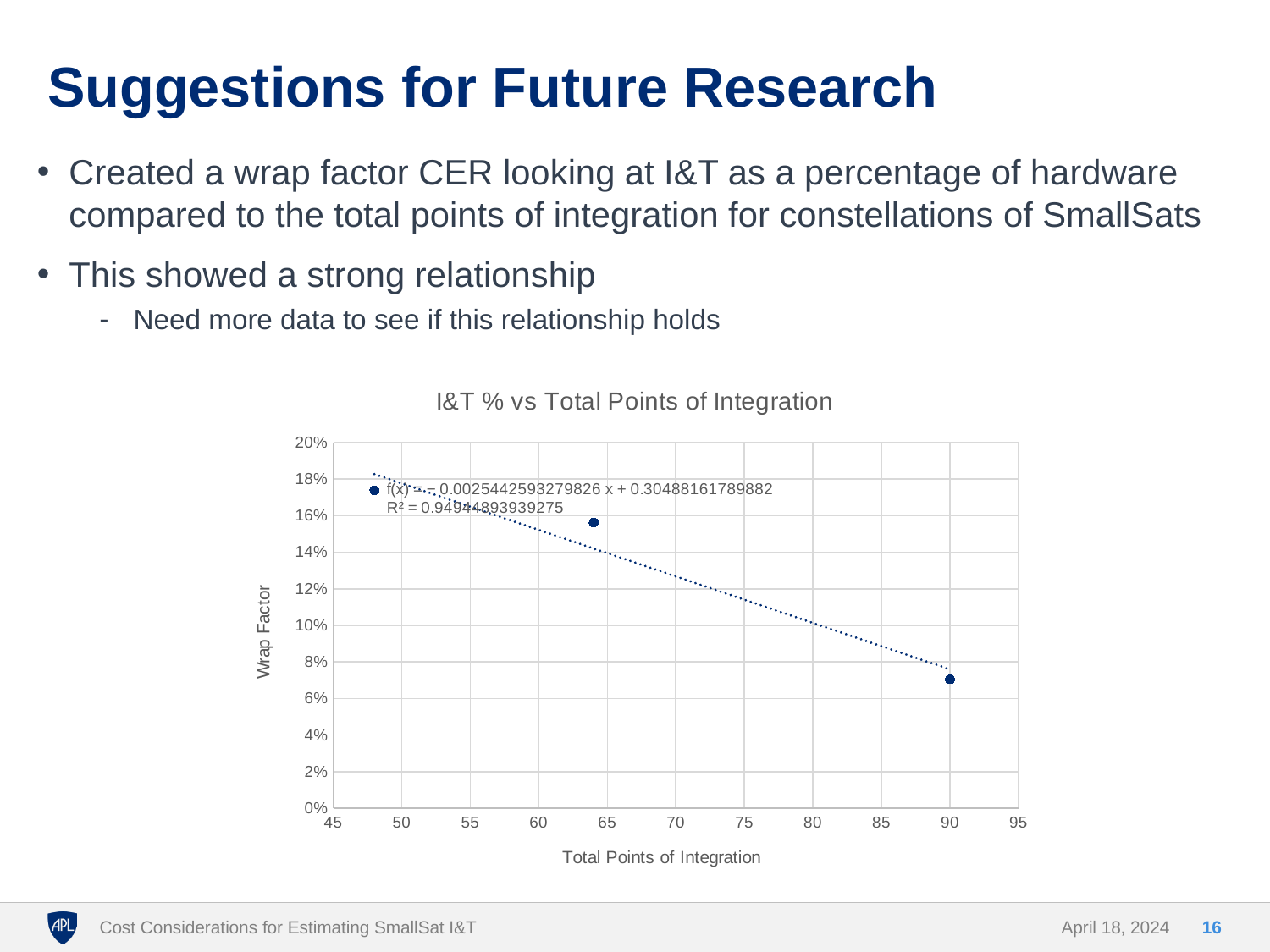
Does the wrap factor rise or fall as total points of integration increases? fall Is the wrap factor for the point at 90 total points of integration greater or less than 8%? less Which has the larger wrap factor, the leftmost point or the middle point? leftmost point What kind of chart is shown on the slide? scatter chart Is the wrap factor for the rightmost point greater or less than 10%? less Is the wrap factor for the middle point greater or less than 14%? greater What is the label of the y axis? Wrap Factor What R² value is printed on the chart for the trendline? 0.949448939393275 What is the title of the chart? I&T % vs Total Points of Integration Which point has the lowest wrap factor, the leftmost or the rightmost? rightmost How many data points are plotted in the chart? 3